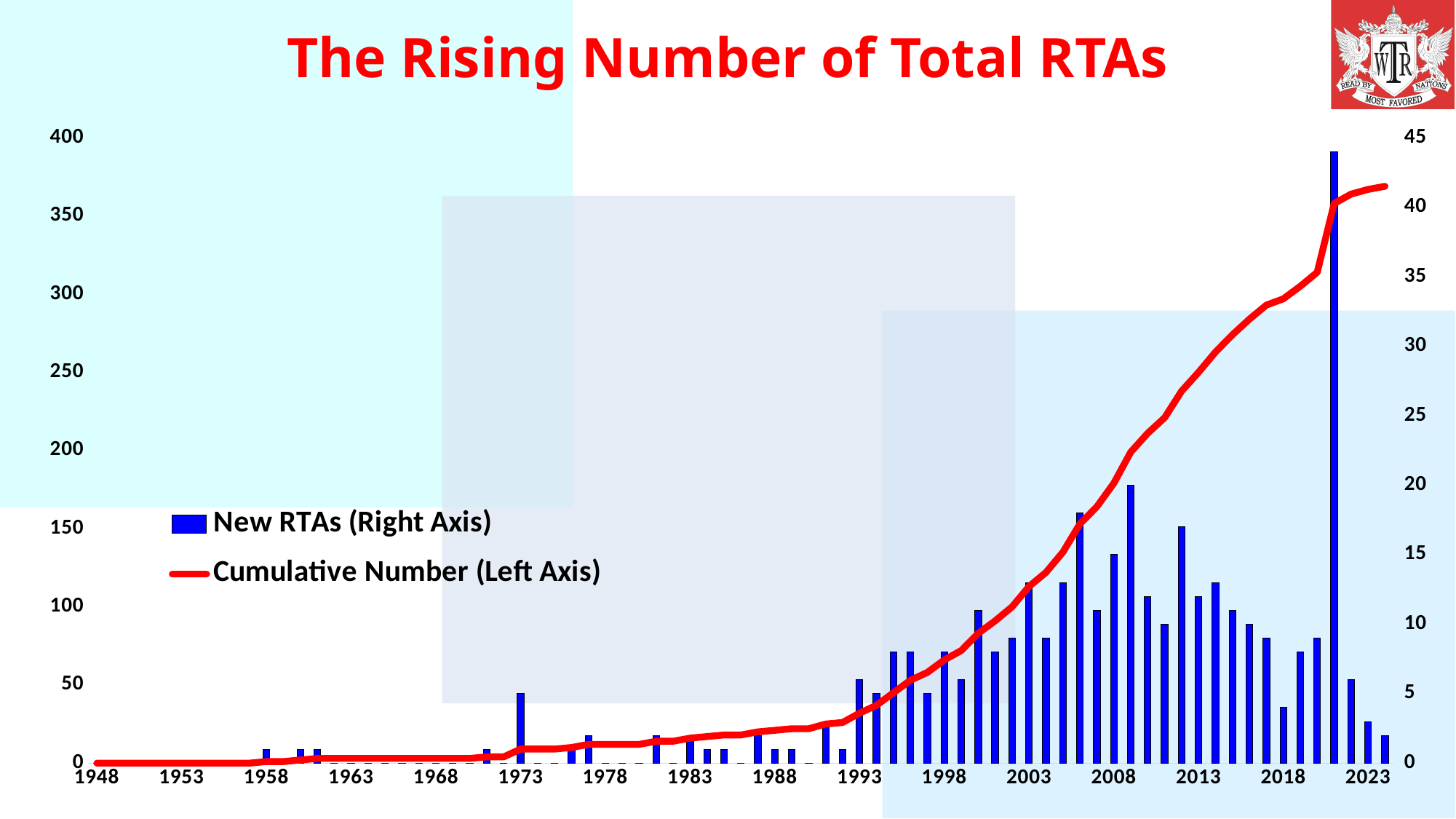
How many year labels are shown on the x axis? 16 Is the Cumulative Number value at 2013 greater or less than 200? greater Does the Cumulative Number line rise or fall from 1948 to 2023? Rise Is the tallest New RTAs bar greater or less than 40 on the right axis? greater Which year has the larger New RTAs bar, 2003 or 2023? 2003 How many series does the legend list? 2 What is the title of the chart? The Rising Number of Total RTAs Is the New RTAs value for 2008 greater or less than 10? greater Which axis does the legend say the Cumulative Number series is plotted against? Left Axis What kind of chart is shown on the slide? A combined bar and line chart